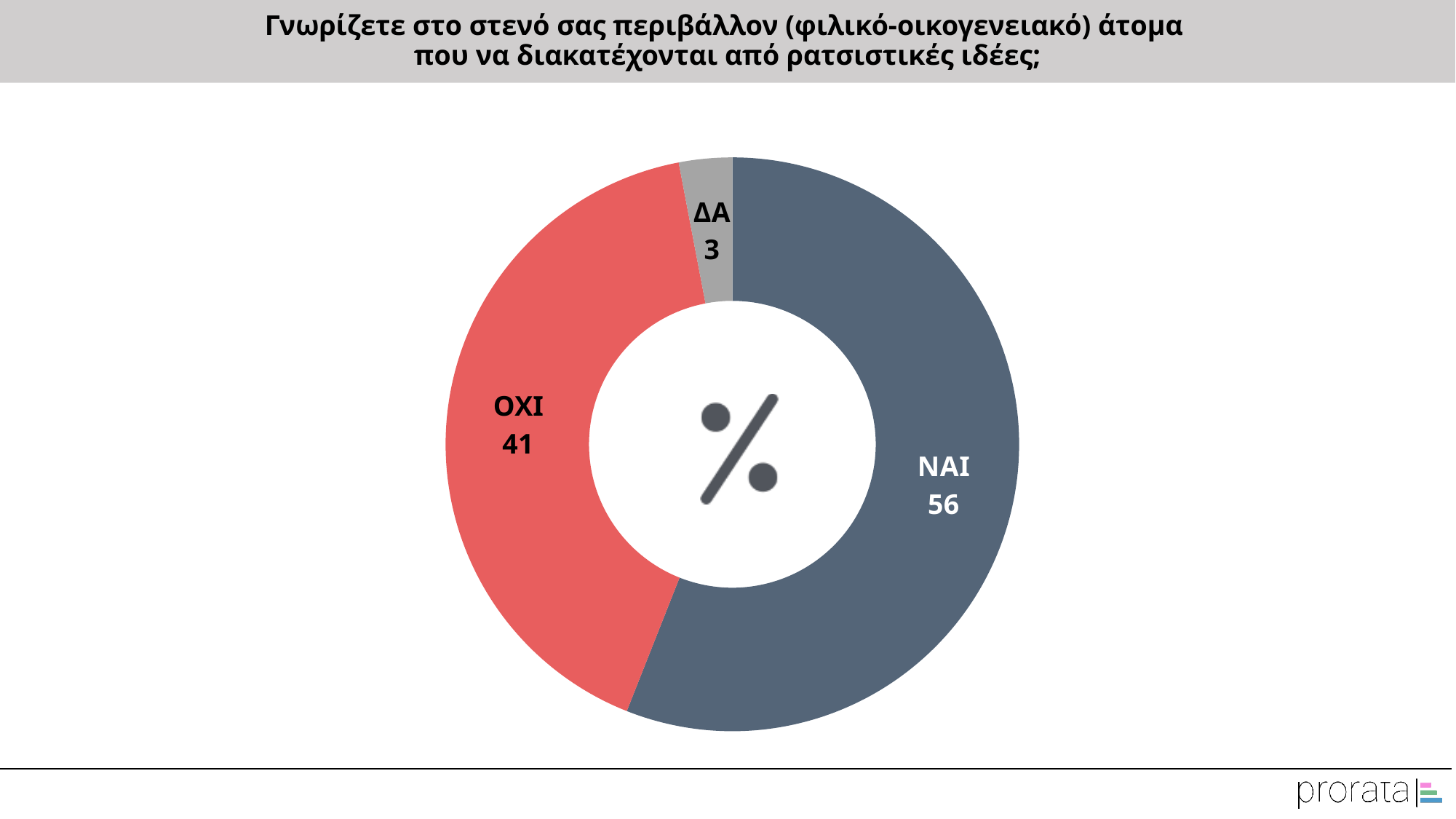
What kind of chart is shown on the slide? Pie chart (doughnut) What is the value for ΝΑΙ? 56 What is the total of the three values shown? 100 How many categories does the chart show? 3 What is the value for ΟΧΙ? 41 What colour is the ΟΧΙ slice? Red Which is larger, ΟΧΙ or ΔΑ? ΟΧΙ Which category has the largest share? ΝΑΙ What is the value for ΔΑ? 3 What symbol is shown in the centre of the chart? A percent sign (%) What is the difference between the values for ΝΑΙ and ΟΧΙ? 15 Which category has the smallest share? ΔΑ